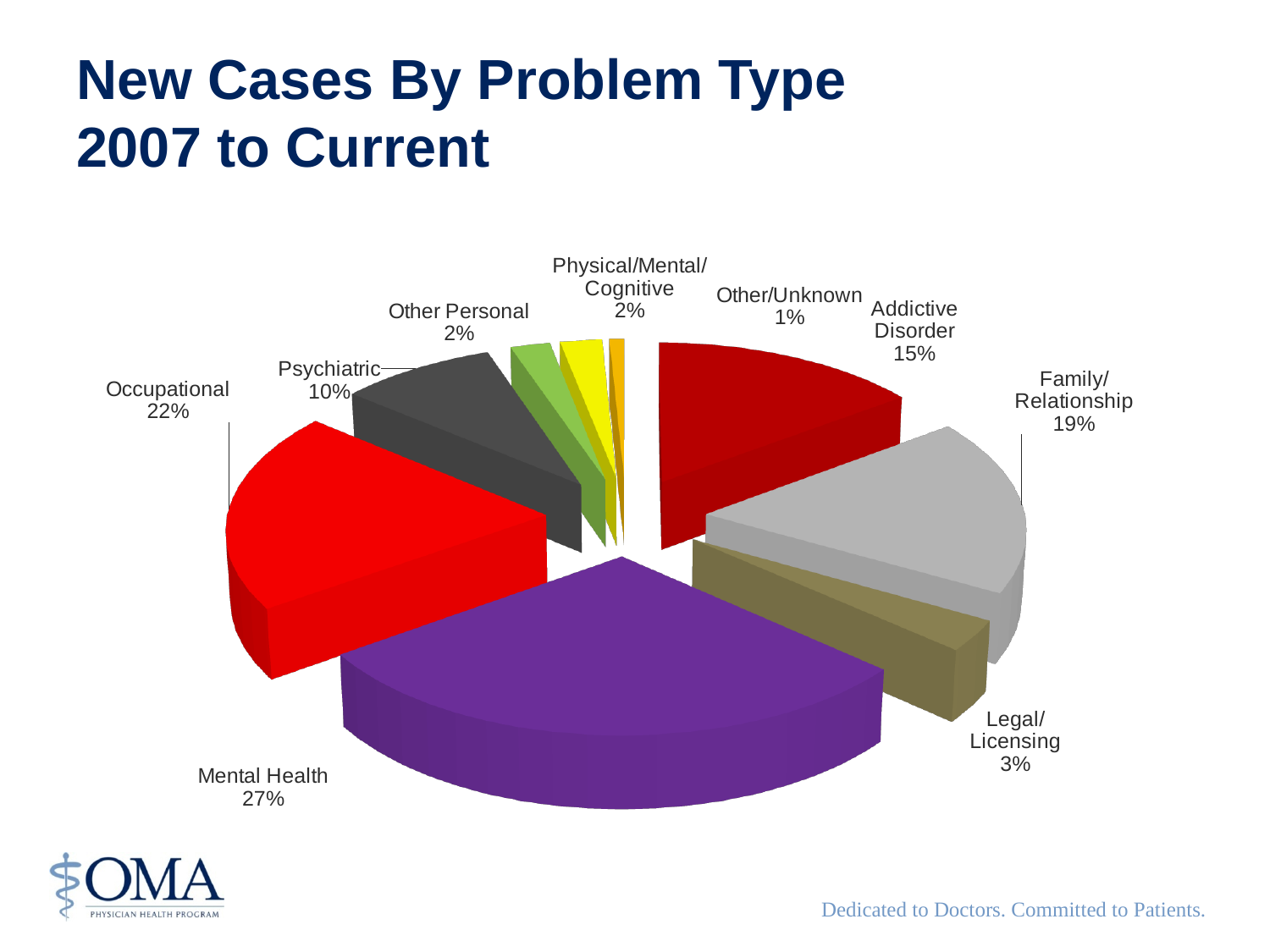
What share of new cases is Mental Health? 27% What percentage of new cases is Addictive Disorder? 15% What percentage is shown for Legal/Licensing? 3% What colour is the Mental Health slice? Purple Which is larger, Family/Relationship or Addictive Disorder? Family/Relationship What kind of chart is shown on the slide? Pie chart Which problem type has the smallest share of new cases? Other/Unknown What is the title of the chart? New Cases By Problem Type 2007 to Current What is the value shown for Family/Relationship? 19% What is the difference in percentage points between Occupational and Psychiatric? 12 How many problem type categories are shown in the pie chart? 9 Which problem type has the largest share of new cases? Mental Health